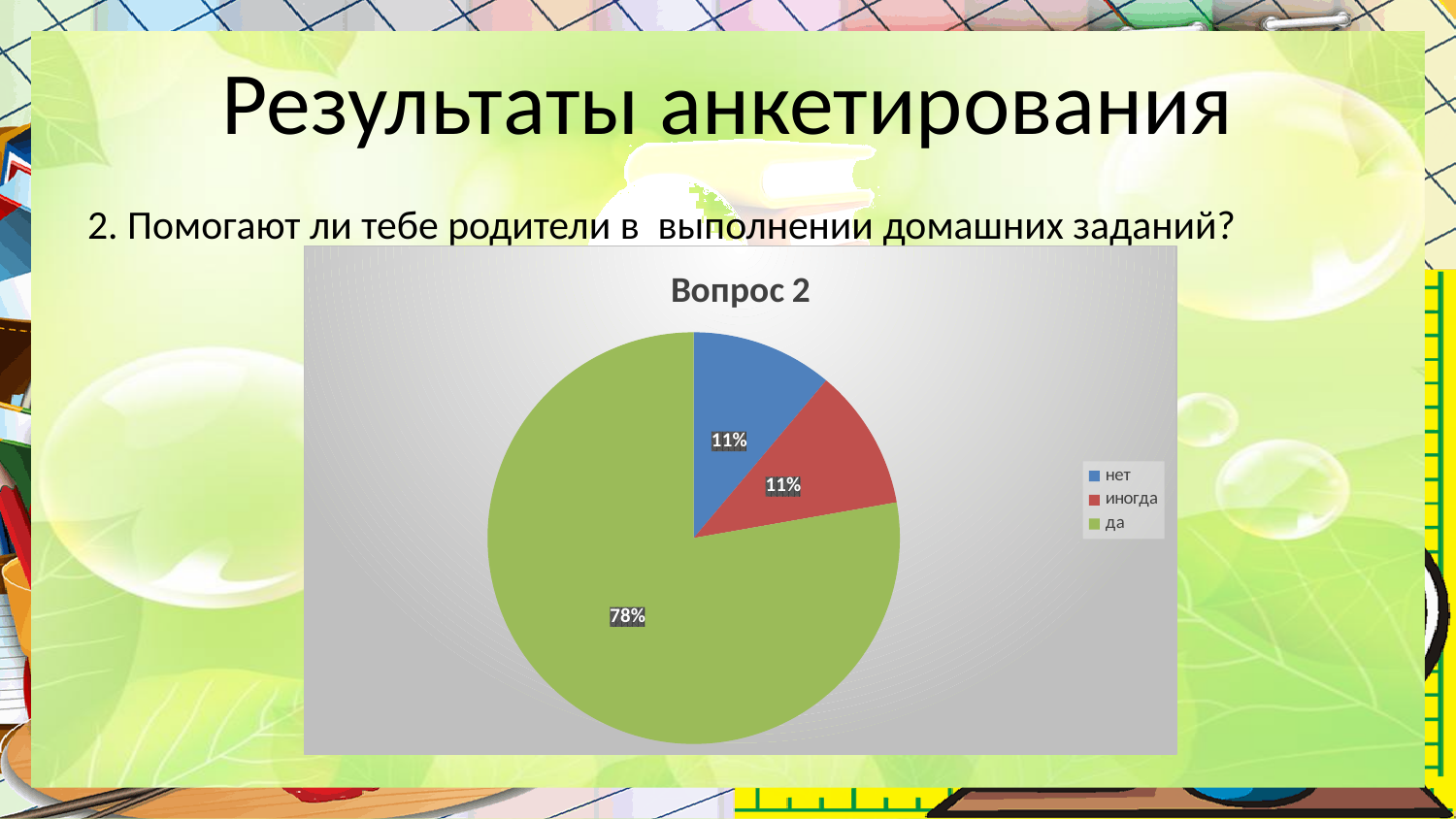
What colour is the 'да' slice? green Which is larger, the 'да' slice or the 'иногда' slice? да What share of the pie does the 'да' slice take? 78% What is the chart's title? Вопрос 2 What is the combined share of the 'нет' and 'иногда' slices? 22% What kind of chart is shown on the slide? pie chart What is the difference between the 'да' share and the 'нет' share? 67% How many categories does the legend list? 3 What share of the pie does the 'нет' slice take? 11% Which category has the largest slice of the pie? да What share of the pie does the 'иногда' slice take? 11%